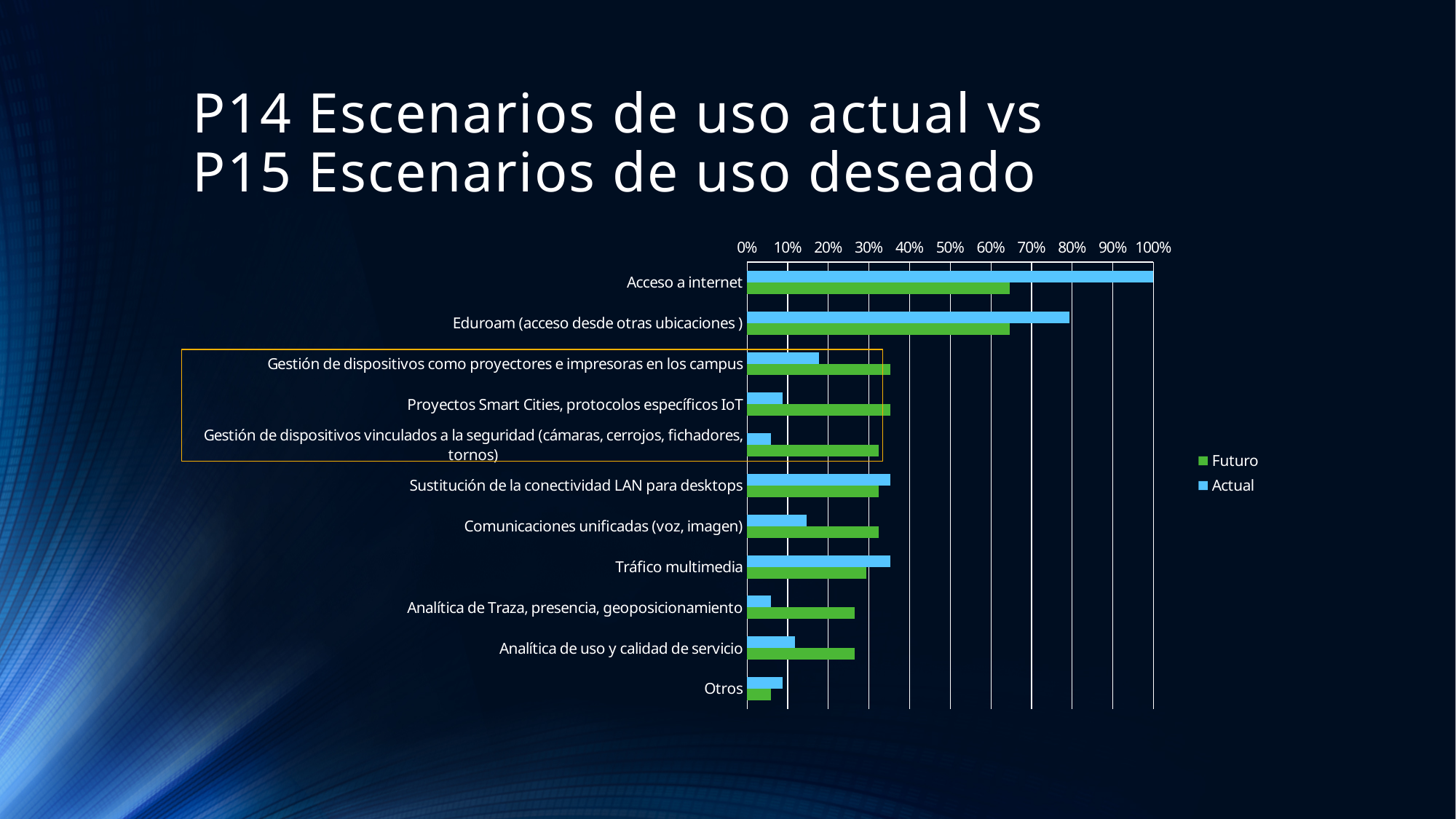
Is the Actual value for Eduroam (acceso desde otras ubicaciones ) greater or less than 70%? greater What kind of chart is shown on the slide? bar chart Which colour represents the Futuro series in the legend? green For Gestión de dispositivos como proyectores e impresoras en los campus, which series has the larger value, Futuro or Actual? Futuro What is the Actual value for Acceso a internet? 100% For Eduroam (acceso desde otras ubicaciones ), which series has the larger value, Futuro or Actual? Actual Which category has the lowest Futuro value? Otros How many categories are plotted on the chart? 11 How many series does the legend list? 2 Is the Futuro value for Acceso a internet greater or less than 60%? greater Which category has the highest Actual value? Acceso a internet